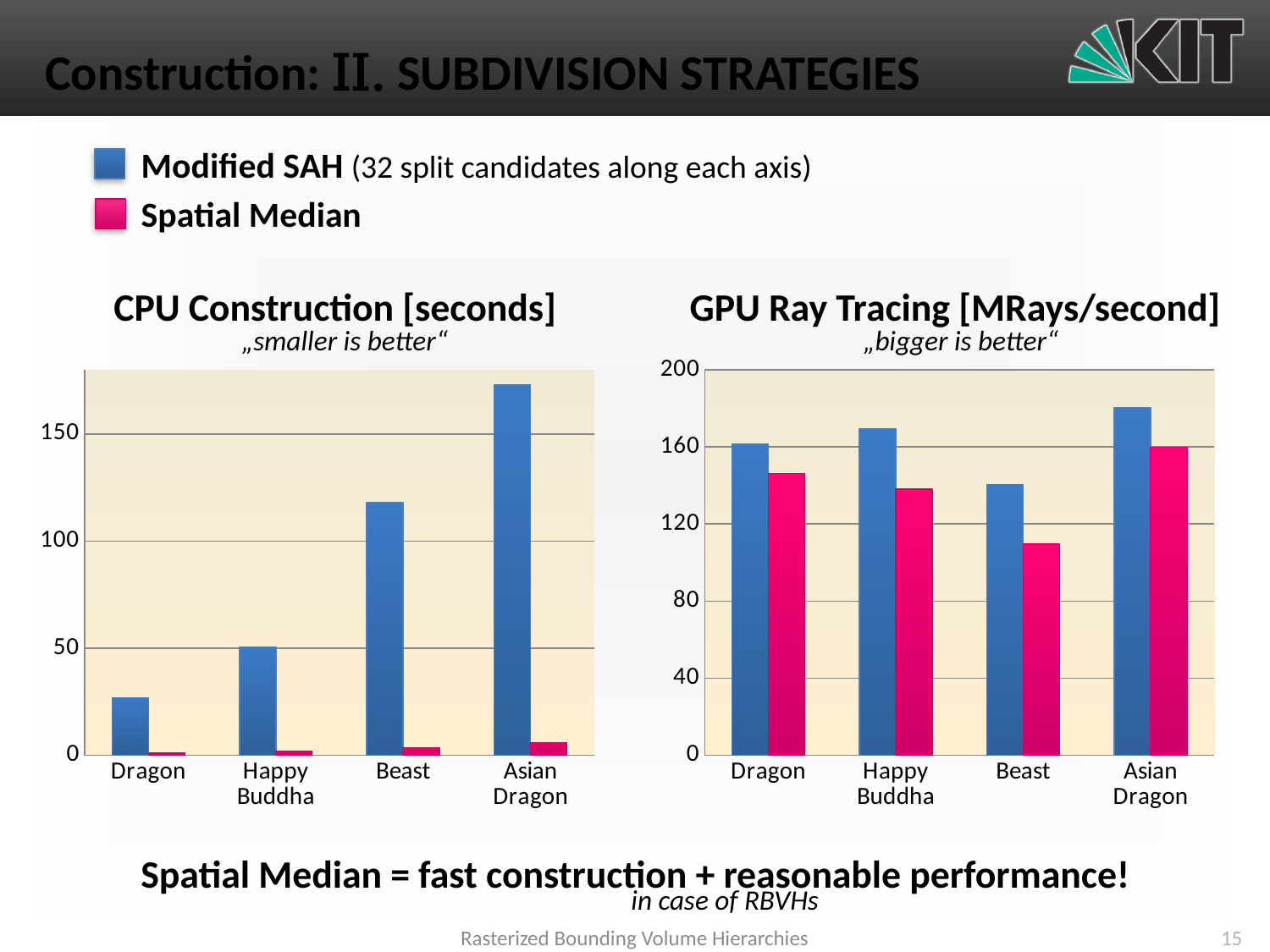
What kind of chart is the CPU Construction [seconds] chart? bar chart In the GPU Ray Tracing [MRays/second] chart, which is larger for Dragon: Modified SAH or Spatial Median? Modified SAH In the GPU Ray Tracing [MRays/second] chart, which category has the highest Modified SAH value? Asian Dragon In the GPU Ray Tracing [MRays/second] chart, is the Spatial Median value for Beast greater or less than 120? less In the GPU Ray Tracing [MRays/second] chart, which category has the lowest Spatial Median value? Beast In the CPU Construction [seconds] chart, is the Modified SAH value for Happy Buddha greater or less than 100? less In the CPU Construction [seconds] chart, which category has the lowest Modified SAH value? Dragon How many categories are shown on the x axis of the GPU Ray Tracing [MRays/second] chart? 4 In the CPU Construction [seconds] chart, do the Modified SAH values rise or fall from Dragon to Asian Dragon? rise In the CPU Construction [seconds] chart, which category has the highest Modified SAH value? Asian Dragon In the CPU Construction [seconds] chart, is the Modified SAH value for Beast greater or less than 100? greater How many series does the legend on the slide list? 2